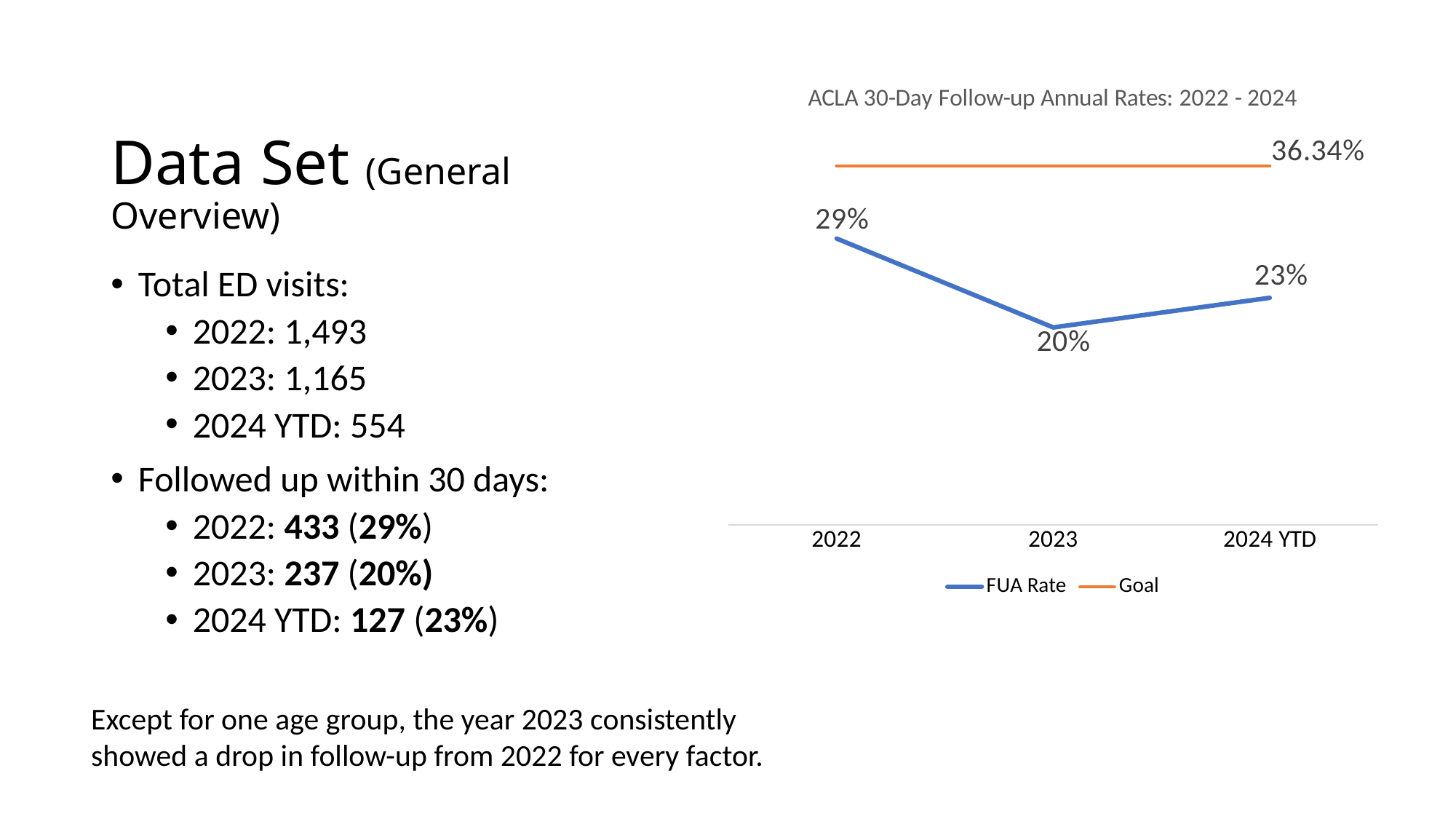
How many series does the legend list? 2 How many time periods are shown on the x axis? 3 What is the difference between the FUA Rate in 2022 and in 2023? 9% What is the title of the chart? ACLA 30-Day Follow-up Annual Rates: 2022 - 2024 What is the FUA Rate for 2024 YTD? 23% Which year has the highest FUA Rate? 2022 What is the FUA Rate for 2023? 20% What value is shown for the Goal line? 36.34% Is the FUA Rate higher in 2024 YTD or in 2023? 2024 YTD What kind of chart is this? Line chart Which year has the lowest FUA Rate? 2023 What is the FUA Rate for 2022? 29%